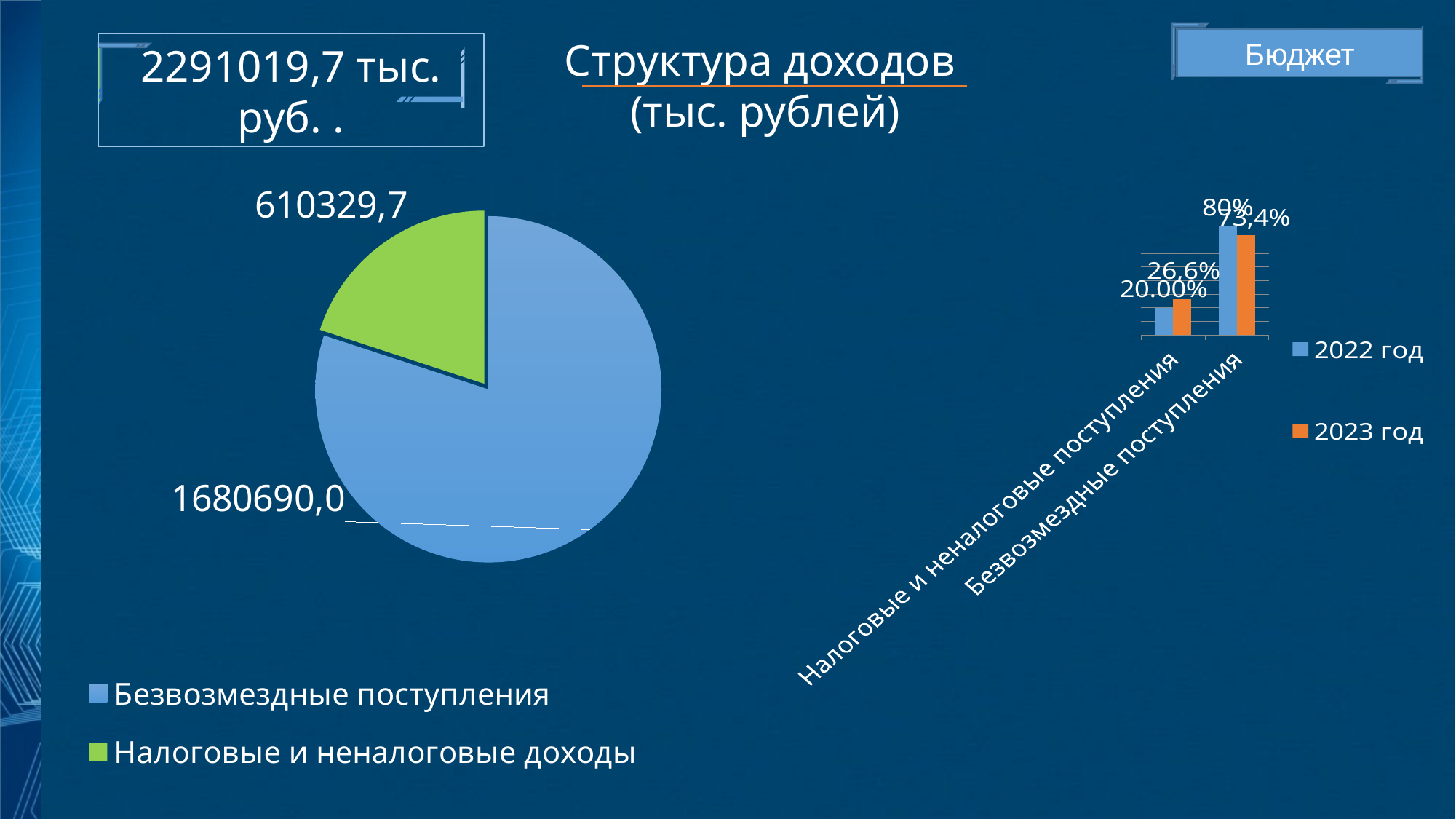
In the bar chart on the right, how many series does the legend list? 2 In the pie chart on the left, which category has the larger slice? Безвозмездные поступления In the pie chart on the left, what is the value for Налоговые и неналоговые доходы? 610329,7 In the bar chart on the right, what is the value for Налоговые и неналоговые поступления in 2022 год? 20.00% What kind of chart is the chart on the right of the slide? bar chart In the pie chart on the left, what is the value for Безвозмездные поступления? 1680690,0 In the bar chart on the right, what is the value for Безвозмездные поступления in 2023 год? 73,4% In the bar chart on the right, which is larger for Безвозмездные поступления: 2022 год or 2023 год? 2022 год In the pie chart on the left, what is the difference between the values for Безвозмездные поступления and Налоговые и неналоговые доходы? 1070360,3 What kind of chart is the chart on the left of the slide? pie chart In the bar chart on the right, what is the difference between the 2023 год and 2022 год values for Налоговые и неналоговые поступления? 6,6% In the pie chart on the left, how many slices are there? 2